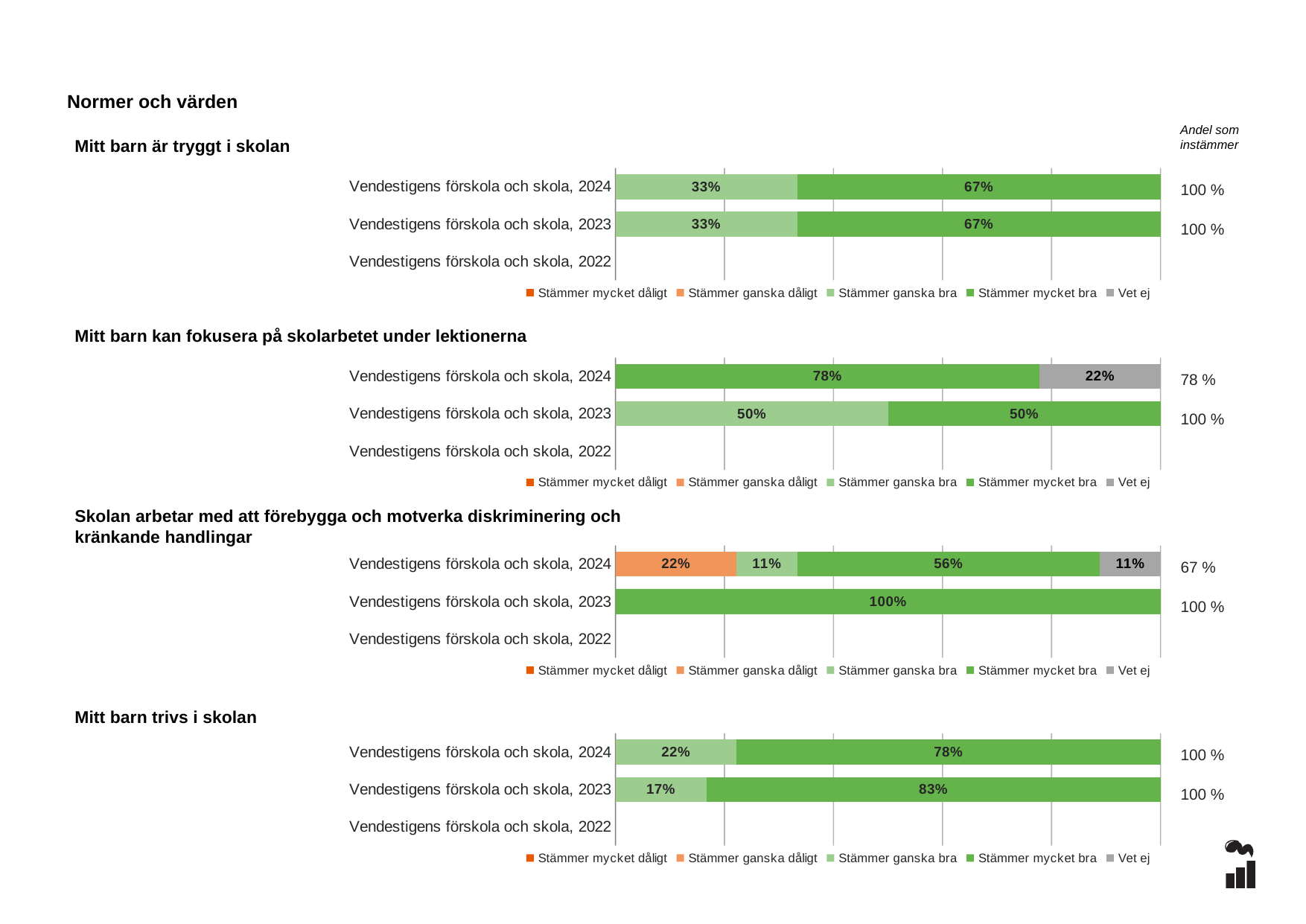
In the chart 'Mitt barn trivs i skolan', which year has the larger 'Stämmer ganska bra' value, 2024 or 2023? 2024 In the chart 'Mitt barn trivs i skolan', what is the 'Andel som instämmer' shown for Vendestigens förskola och skola, 2023? 100 % In the chart 'Mitt barn kan fokusera på skolarbetet under lektionerna', what is the 'Andel som instämmer' shown for Vendestigens förskola och skola, 2024? 78 % In the chart 'Mitt barn är tryggt i skolan', what is the value for 'Stämmer mycket bra' for Vendestigens förskola och skola, 2024? 67% In the chart 'Skolan arbetar med att förebygga och motverka diskriminering och kränkande handlingar', which segment is largest for Vendestigens förskola och skola, 2024? Stämmer mycket bra What kind of chart is 'Mitt barn kan fokusera på skolarbetet under lektionerna'? Stacked bar chart How many series does the legend list in the chart 'Mitt barn är tryggt i skolan'? 5 In the chart 'Mitt barn är tryggt i skolan', what is the value for 'Stämmer ganska bra' for Vendestigens förskola och skola, 2023? 33% In the chart 'Mitt barn trivs i skolan', what is the difference between the 'Stämmer mycket bra' values for 2023 and 2024? 5% In the chart 'Skolan arbetar med att förebygga och motverka diskriminering och kränkande handlingar', what is the value for 'Stämmer ganska dåligt' for Vendestigens förskola och skola, 2024? 22% In the chart 'Skolan arbetar med att förebygga och motverka diskriminering och kränkande handlingar', what is the value for 'Stämmer mycket bra' for Vendestigens förskola och skola, 2023? 100% In the chart 'Mitt barn kan fokusera på skolarbetet under lektionerna', what is the value for 'Vet ej' for Vendestigens förskola och skola, 2024? 22%